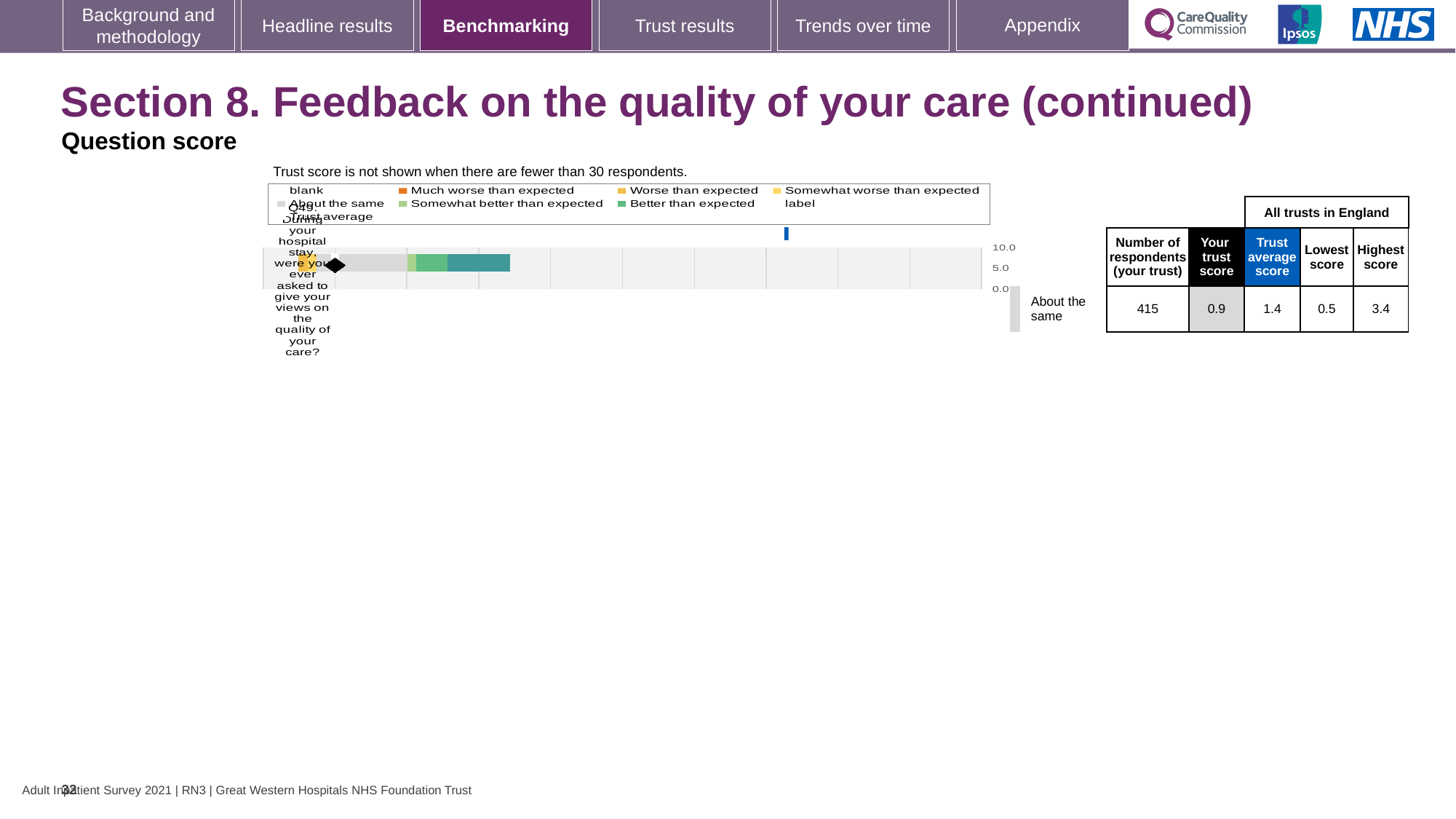
What is the lowest score among all trusts in England for Q49? 0.5 What benchmark category is this trust's Q49 score placed in? About the same Is this trust's score for Q49 greater or less than 5.0? less What kind of chart is used to show the Q49 benchmarking result? Bar chart What is the difference between the highest and lowest scores for Q49 across all trusts in England? 2.9 How many questions are plotted on the chart? 1 What is the trust score for Q49 (During your hospital stay, were you ever asked to give your views on the quality of your care?)? 0.9 What is the difference between the trust average score and this trust's score for Q49? 0.5 Which is larger for Q49: this trust's score or the trust average score? Trust average score What is the trust average score for Q49? 1.4 What is the highest score among all trusts in England for Q49? 3.4 How many respondents from the trust answered Q49? 415